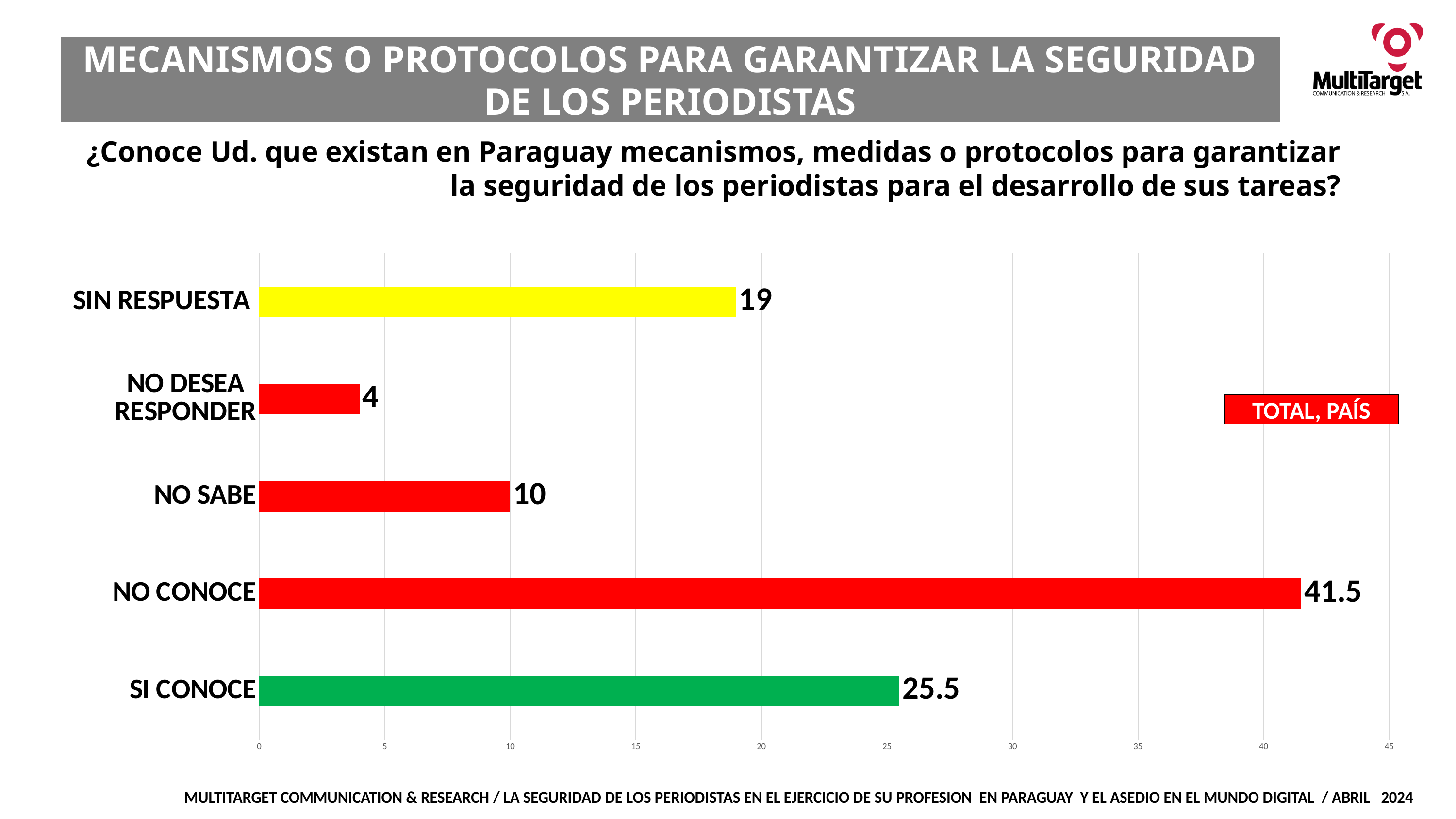
What is the value for NO DESEA RESPONDER? 4 What is the difference between the values for NO CONOCE and SI CONOCE? 16 Which is larger, the value for SIN RESPUESTA or the value for NO SABE? SIN RESPUESTA What is the value for NO CONOCE? 41.5 Is the value for NO CONOCE greater or less than 40? greater What label does the legend show? TOTAL, PAÍS Which category has the highest value? NO CONOCE How many categories are shown in the chart? 5 What is the value for SIN RESPUESTA? 19 What kind of chart is shown on the slide? bar chart What is the value for SI CONOCE? 25.5 Which category has the lowest value? NO DESEA RESPONDER